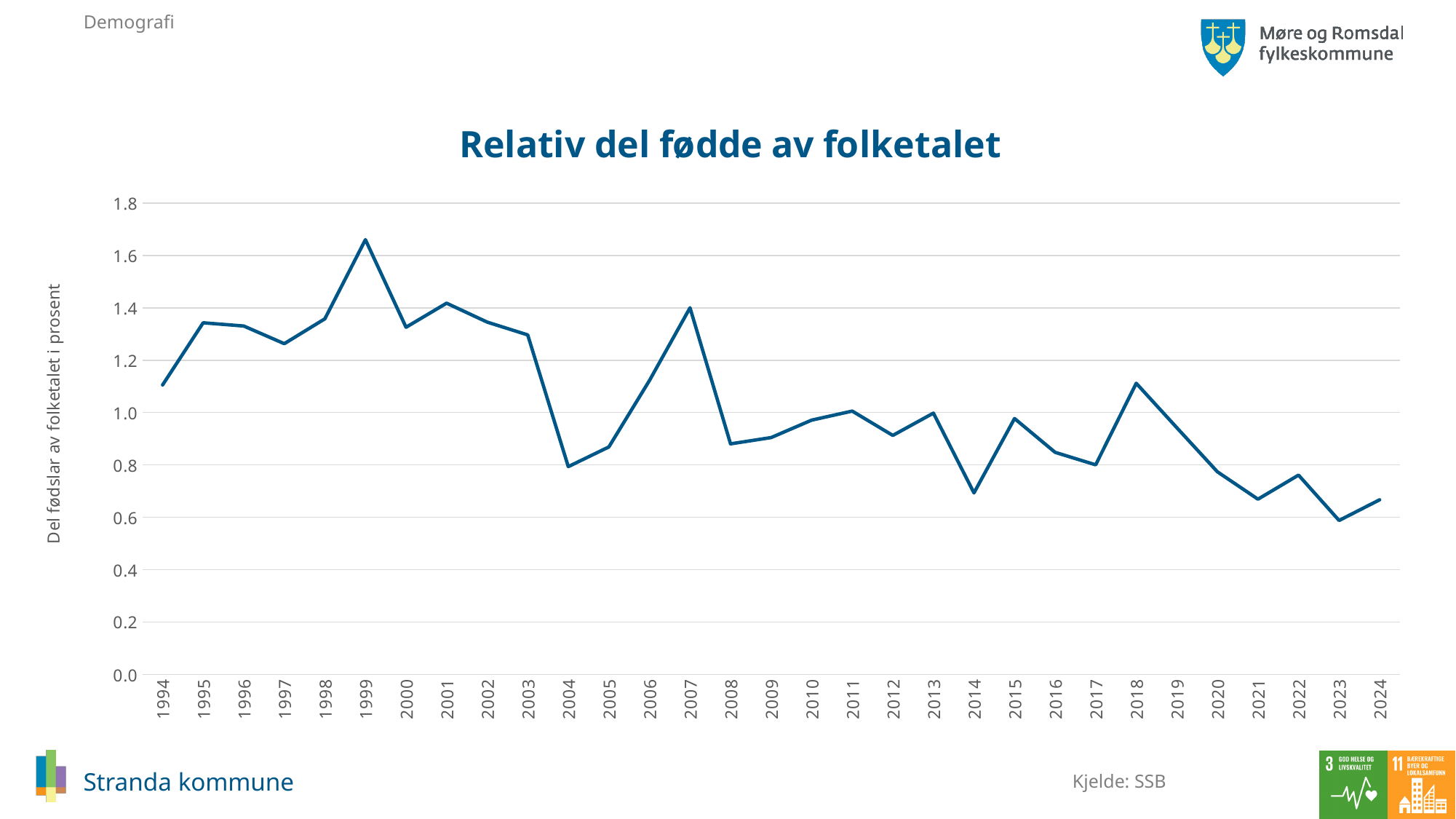
In which year is the value highest? 1999 Is the value for 1999 greater or less than 1.4? greater How many years are plotted along the x axis? 31 In which year is the value lowest? 2023 Which year has the larger value, 1999 or 2007? 1999 Is the value for 1994 greater or less than 1.0? greater Is the value for 2014 greater or less than 0.8? less What is the label on the vertical axis of the chart? Del fødslar av folketalet i prosent What kind of chart is shown on the slide? line chart Which year has the larger value, 2004 or 2018? 2018 What is the title of the chart? Relativ del fødde av folketalet